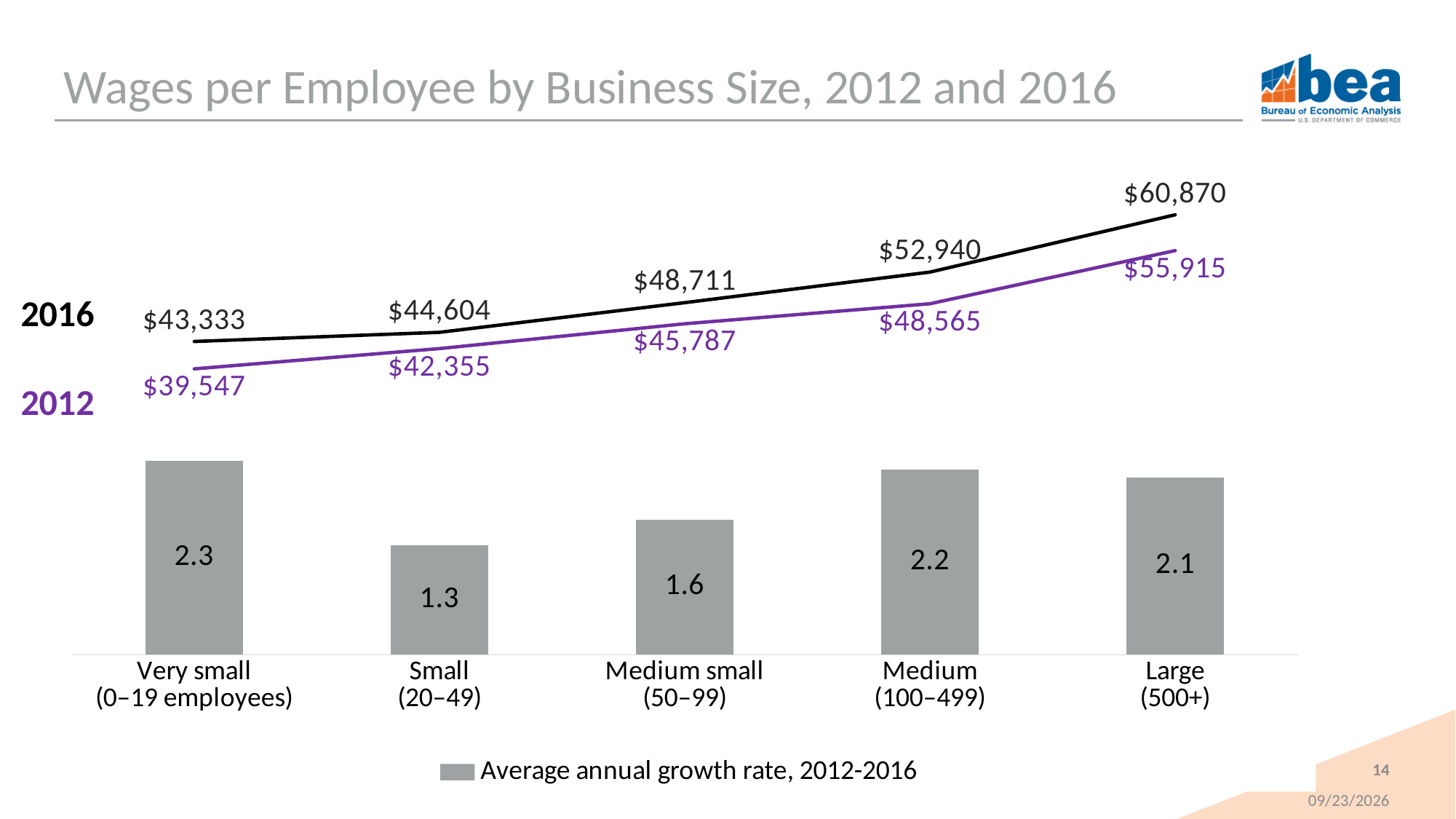
What is the 2012 wage per employee for Very small (0–19 employees) businesses? $39,547 What is the 2016 wage per employee for Large (500+) businesses? $60,870 Which business size has the highest 2016 wage per employee? Large (500+) What does the grey bar series represent according to the legend? Average annual growth rate, 2012-2016 What is the average annual growth rate, 2012-2016, for Medium (100–499) businesses? 2.2 Do the 2016 wages per employee rise or fall as business size increases from Very small to Large? Rise How many business size categories are shown on the x axis? 5 What colour is the line for 2012 wages per employee? Purple What is the difference between the 2016 and 2012 wages per employee for Large (500+) businesses? $4,955 Which is larger: the 2012 wage per employee for Medium (100–499) businesses or the 2016 wage per employee for Medium small (50–99) businesses? 2016 wage for Medium small (50–99) Which business size has the lowest average annual growth rate, 2012-2016? Small (20–49) Which business size has the highest average annual growth rate, 2012-2016? Very small (0–19 employees)